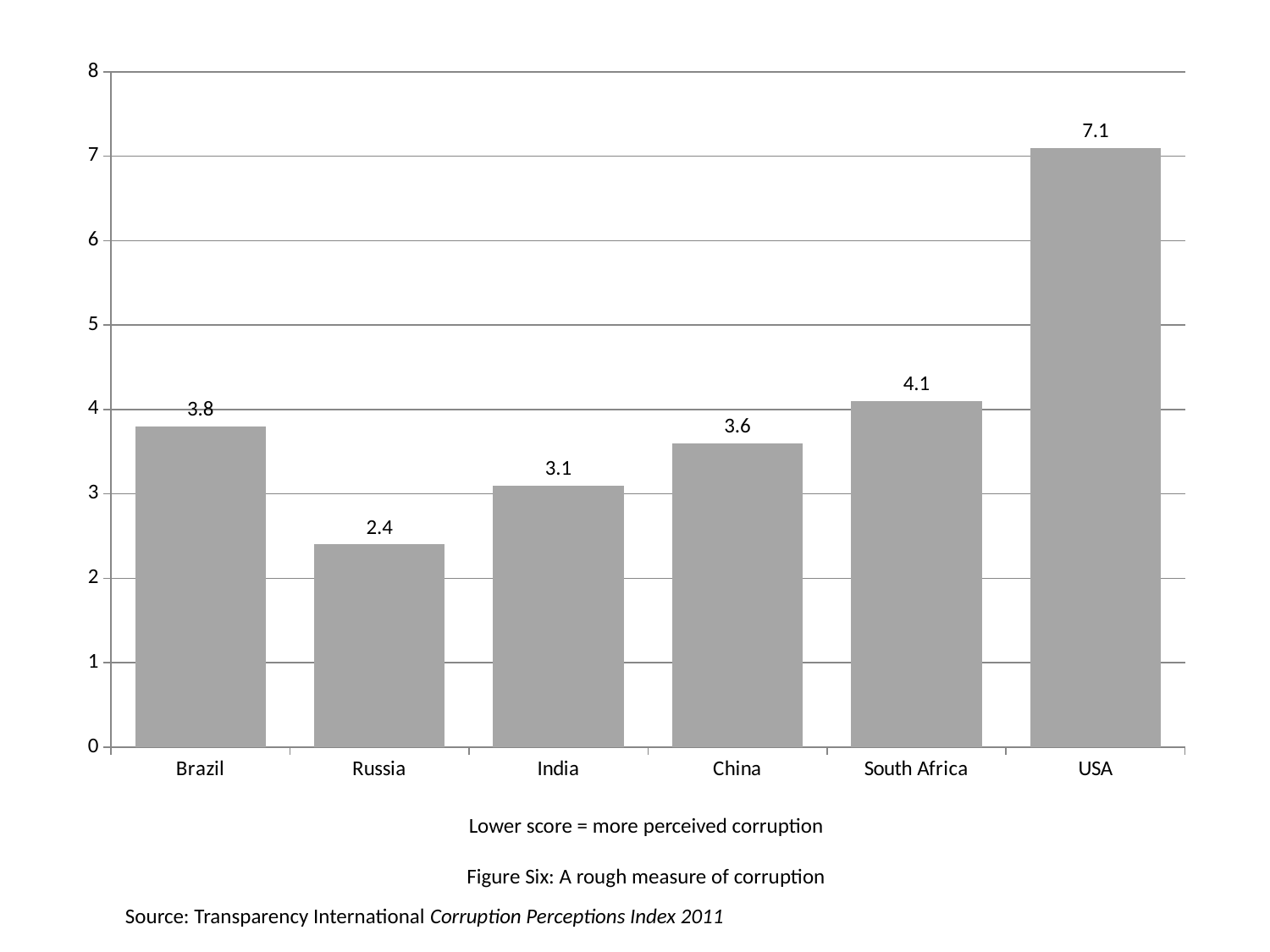
Is the value for South Africa greater or less than 4? greater How many countries are shown on the chart? 6 Which is larger, the value for China or the value for India? China What is the value for South Africa? 4.1 What is the figure caption shown below the chart? Figure Six: A rough measure of corruption What is the value for Russia? 2.4 Which country has the lowest value? Russia What is the difference between the values for Brazil and India? 0.7 What kind of chart is this? bar chart Which country has the highest value? USA What is the difference between the values for USA and China? 3.5 What is the value for Brazil? 3.8